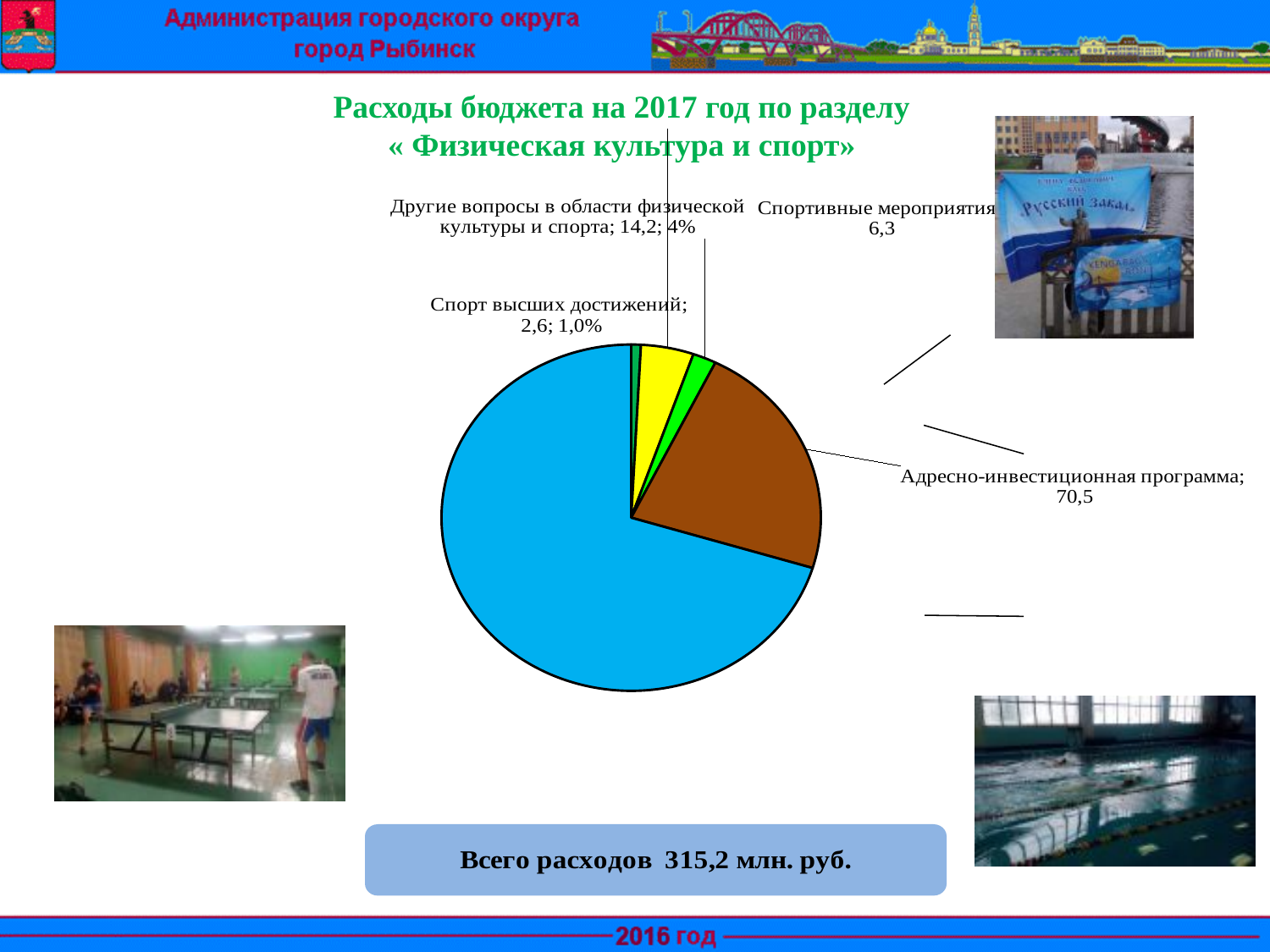
What is the value for Адресно-инвестиционная программа? 70,5 What colour is the slice for Адресно-инвестиционная программа? brown What is the difference between Адресно-инвестиционная программа and Спортивные мероприятия? 64,2 How many slices does the pie chart have? 5 Which slice of the pie is the smallest? Спорт высших достижений What kind of chart is shown on the slide? pie chart What share of the pie does Другие вопросы в области физической культуры и спорта take? 4% What is the value for Спортивные мероприятия? 6,3 What is the value for Спорт высших достижений? 2,6 What is the value for Другие вопросы в области физической культуры и спорта? 14,2 What share of the pie does Спорт высших достижений take? 1,0% Which is larger, Адресно-инвестиционная программа or Спортивные мероприятия? Адресно-инвестиционная программа